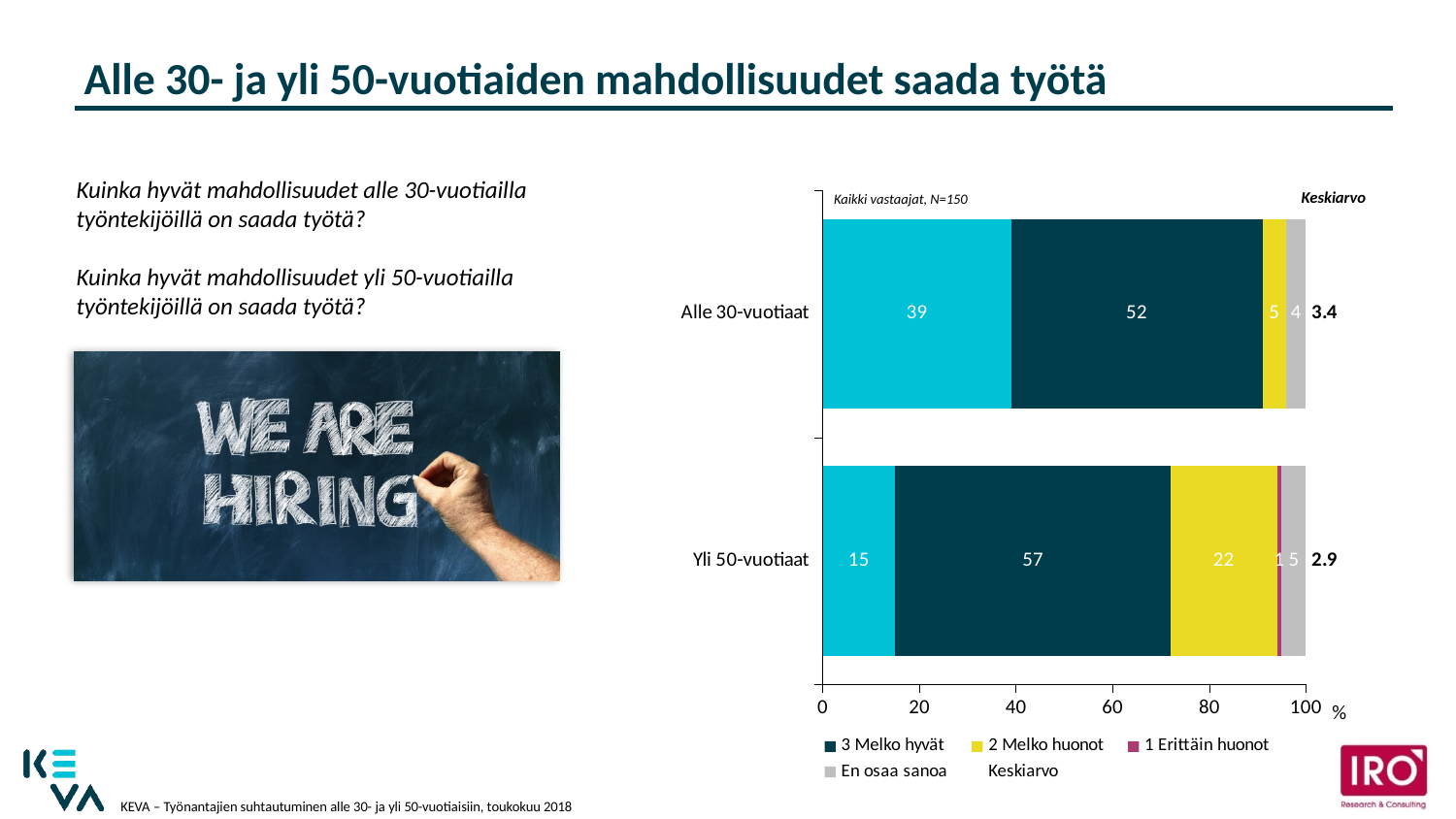
What is the Keskiarvo shown for Alle 30-vuotiaat? 3.4 What is the Keskiarvo shown for Yli 50-vuotiaat? 2.9 What kind of chart is shown on the slide? Stacked bar chart What is the value of "2 Melko huonot" for Yli 50-vuotiaat? 22 What is the value of "En osaa sanoa" for Alle 30-vuotiaat? 4 What is the value of "3 Melko hyvät" for Alle 30-vuotiaat? 52 What is the difference between the "2 Melko huonot" values for Yli 50-vuotiaat and Alle 30-vuotiaat? 17 What is the value of "1 Erittäin huonot" for Yli 50-vuotiaat? 1 How many categories (groups) are shown on the chart? 2 What is the value of "3 Melko hyvät" for Yli 50-vuotiaat? 57 Which group has the larger "3 Melko hyvät" value, Alle 30-vuotiaat or Yli 50-vuotiaat? Yli 50-vuotiaat How many entries does the chart legend list? 5